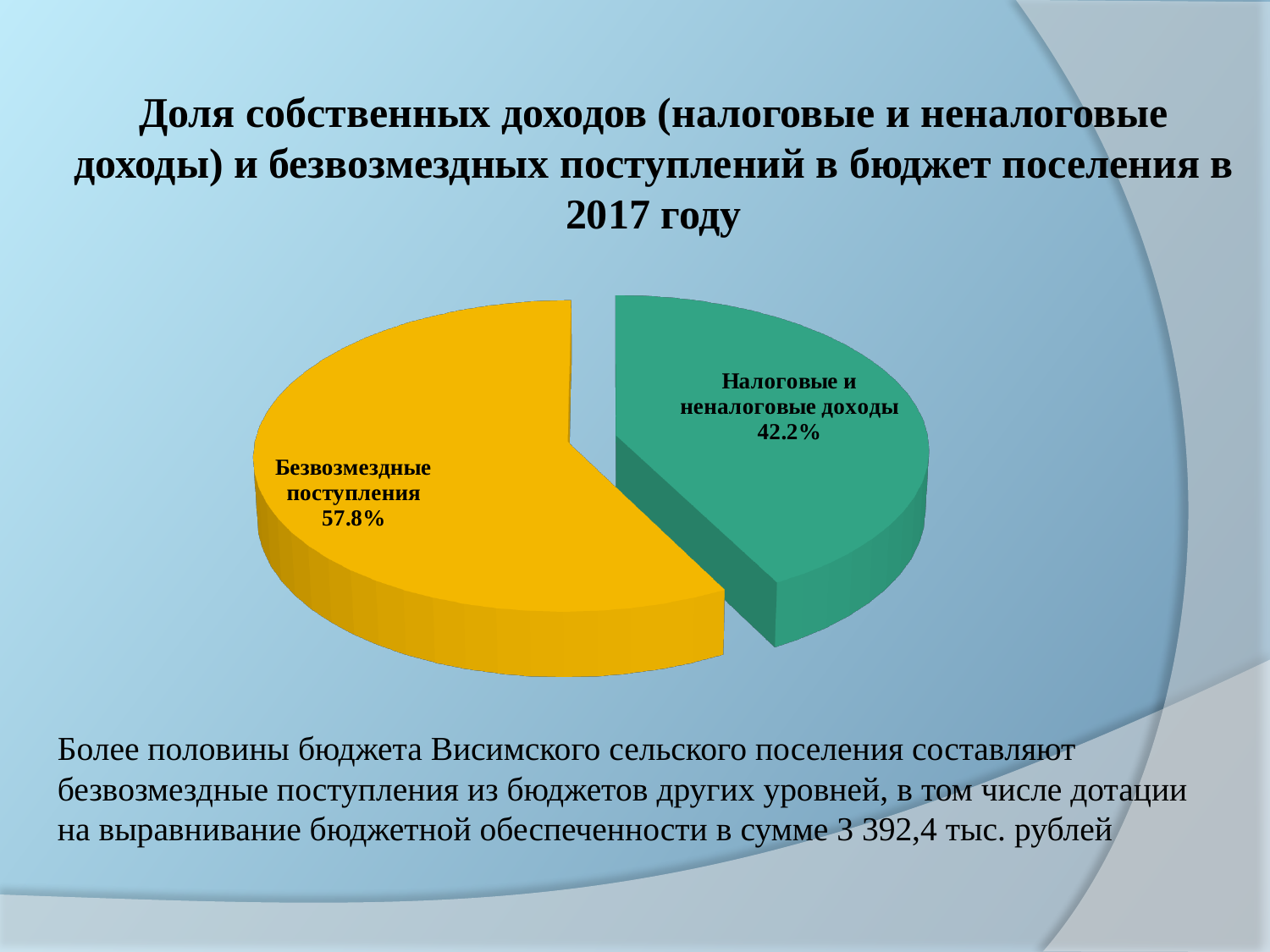
Is the share for "Налоговые и неналоговые доходы" greater or less than 50%? less Which slice of the pie is the largest? Безвозмездные поступления What share of the pie is labelled "Безвозмездные поступления"? 57.8% What kind of chart is shown on the slide? pie chart What is the total of the two slice percentages shown on the pie chart? 100% Which slice of the pie is the smallest? Налоговые и неналоговые доходы What share of the pie is labelled "Налоговые и неналоговые доходы"? 42.2% Which is larger: the share for "Безвозмездные поступления" or the share for "Налоговые и неналоговые доходы"? Безвозмездные поступления What is the difference in percentage points between the "Безвозмездные поступления" slice and the "Налоговые и неналоговые доходы" slice? 15.6 How many slices does the pie chart have? 2 What colour is the "Безвозмездные поступления" slice? yellow What colour is the "Налоговые и неналоговые доходы" slice? green